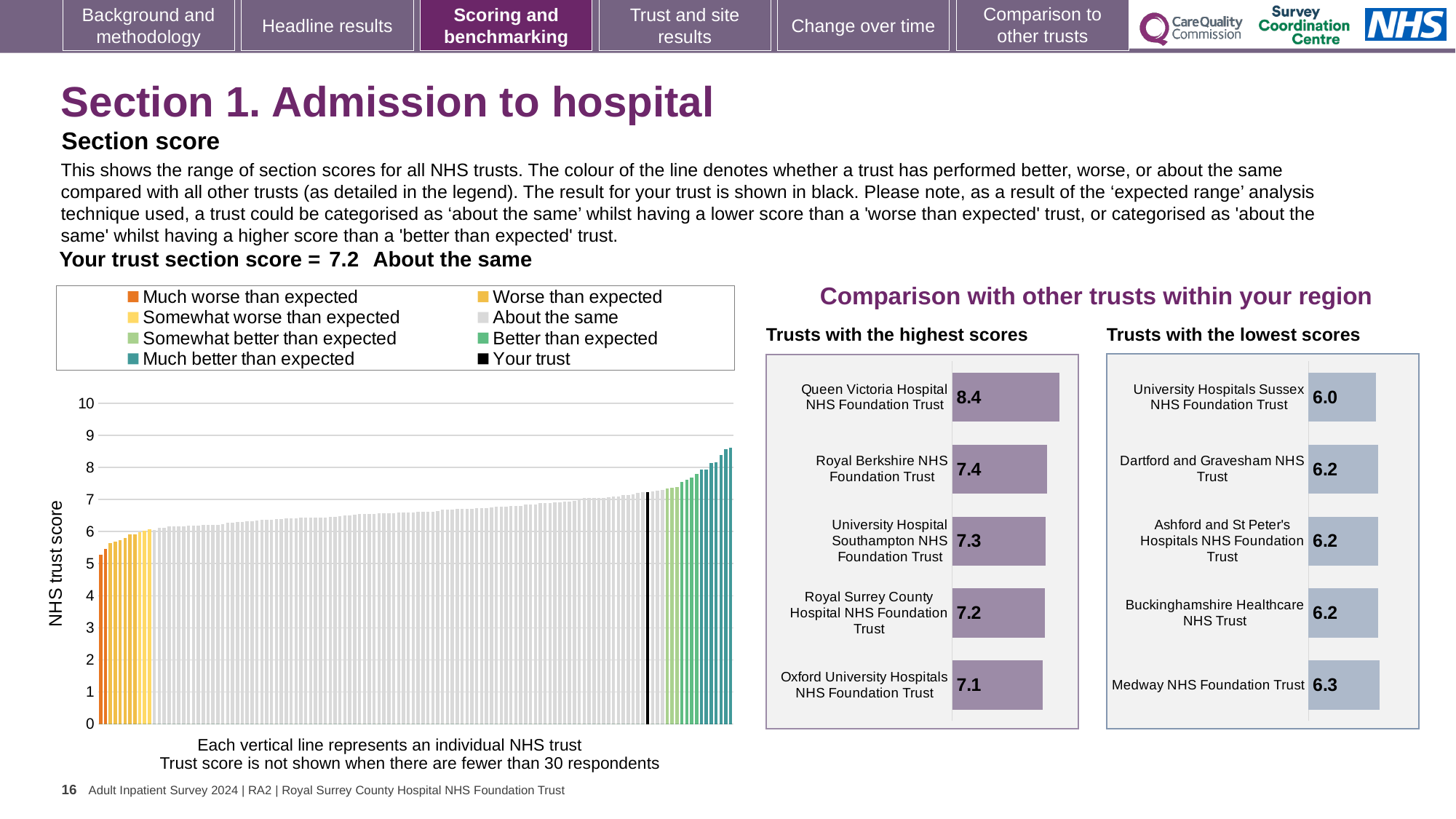
In the NHS trust score chart on the left, do the trust scores rise or fall from left to right? Rise In the 'Trusts with the highest scores' chart, which has the higher score: Royal Berkshire NHS Foundation Trust or University Hospital Southampton NHS Foundation Trust? Royal Berkshire NHS Foundation Trust In the 'Trusts with the highest scores' chart, what is the score for Queen Victoria Hospital NHS Foundation Trust? 8.4 In the 'Trusts with the highest scores' chart, what is the score for Oxford University Hospitals NHS Foundation Trust? 7.1 In the 'Trusts with the lowest scores' chart, which trust has the lowest score? University Hospitals Sussex NHS Foundation Trust How many trusts are shown in the 'Trusts with the highest scores' chart? 5 How many entries does the legend of the NHS trust score chart on the left list? 8 In the 'Trusts with the lowest scores' chart, what is the difference between the scores of Medway NHS Foundation Trust and University Hospitals Sussex NHS Foundation Trust? 0.3 What kind of chart is the NHS trust score chart on the left of the slide? Bar chart In the 'Trusts with the highest scores' chart, which trust has the highest score? Queen Victoria Hospital NHS Foundation Trust In the 'Trusts with the highest scores' chart, what is the difference between the scores of Queen Victoria Hospital NHS Foundation Trust and Royal Berkshire NHS Foundation Trust? 1.0 In the 'Trusts with the lowest scores' chart, what is the score for Medway NHS Foundation Trust? 6.3